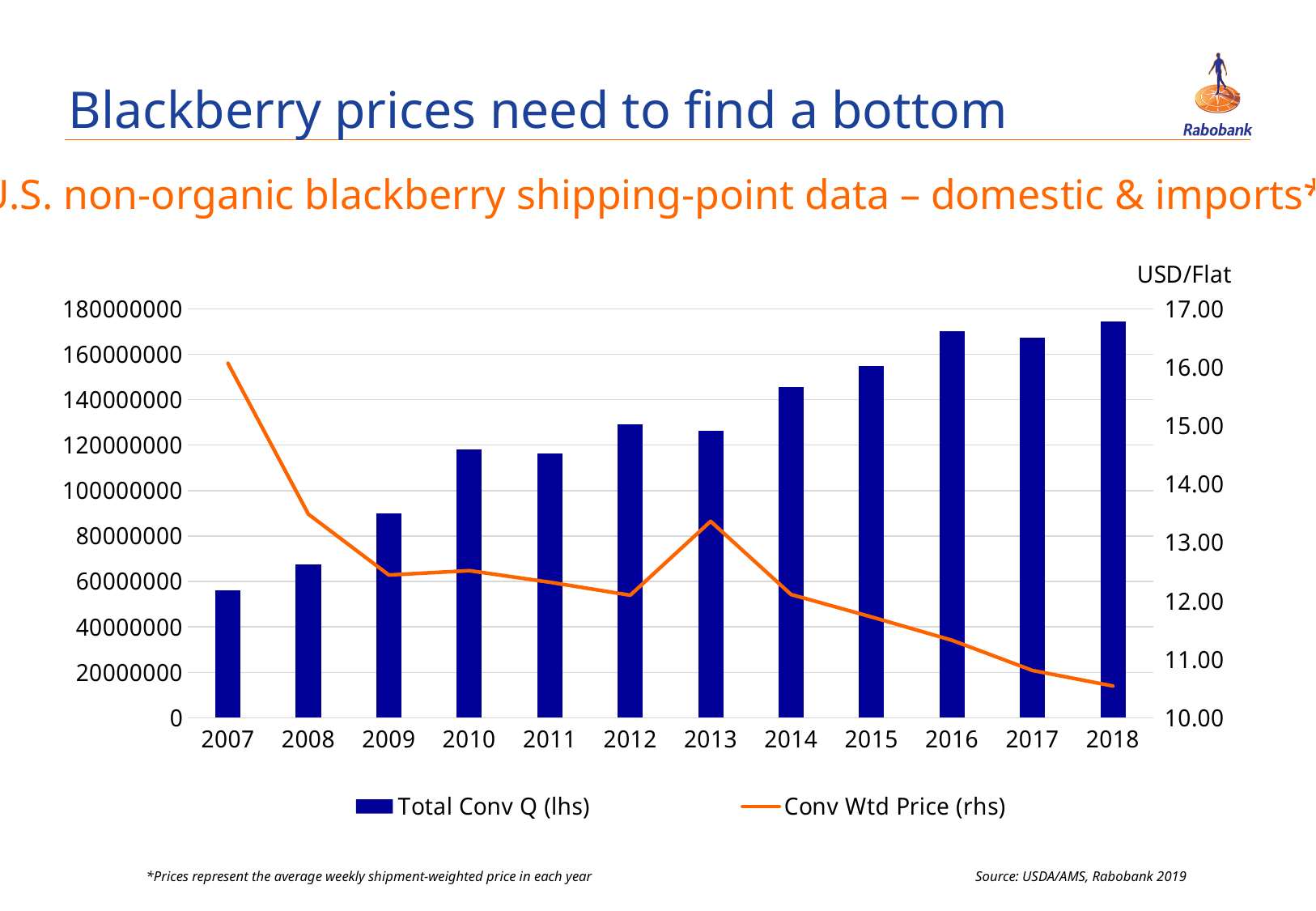
Which year has the shortest Total Conv Q bar? 2007 What unit is shown above the right-hand axis of the chart? USD/Flat Is the Total Conv Q value for 2014 greater or less than 140000000? greater In which year is the Conv Wtd Price line at its lowest? 2018 How many series does the chart's legend list? 2 Which year has the tallest Total Conv Q bar? 2018 In which year is the Conv Wtd Price line at its highest? 2007 How many years are shown on the x axis of the chart? 12 Which year has the larger Total Conv Q bar, 2009 or 2010? 2010 What kind of chart is shown on the slide? A combined bar and line chart Is the Conv Wtd Price for 2008 greater or less than 14.00? less Does the Conv Wtd Price line generally rise or fall from 2007 to 2018? Fall